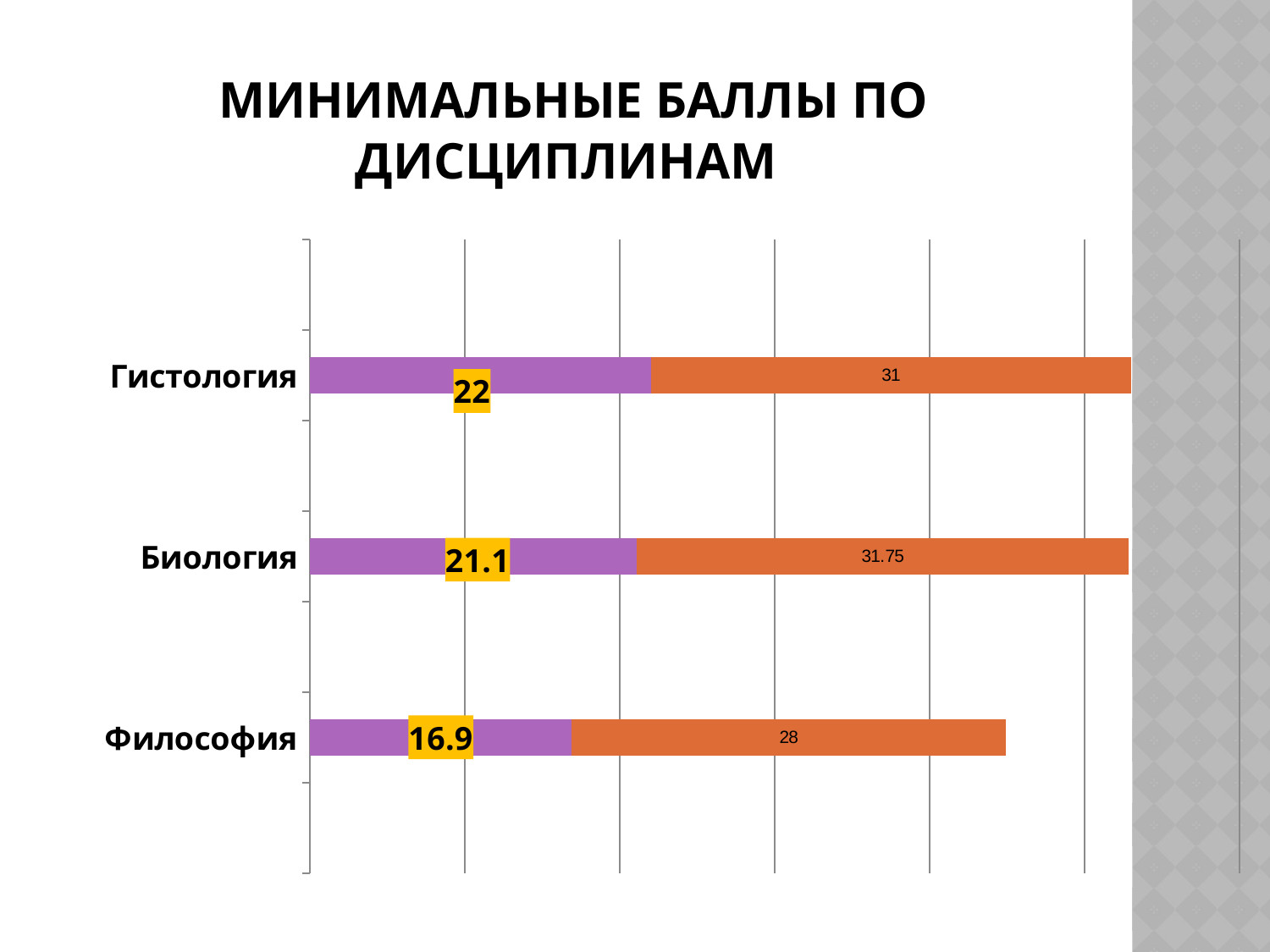
What is the title of the chart on the slide? МИНИМАЛЬНЫЕ БАЛЛЫ ПО ДИСЦИПЛИНАМ Which category has the highest purple segment value? Гистология What is the value of the orange segment for Биология? 31.75 What is the value of the orange segment for Философия? 28 How many categories are shown on the chart? 3 What type of chart is shown on the slide? bar chart Which is larger: the purple segment for Биология or the purple segment for Философия? Биология What is the value of the purple segment for Гистология? 22 Which category has the lowest orange segment value? Философия What is the difference between the orange segment values for Биология and Философия? 3.75 What is the value of the purple segment for Философия? 16.9 What is the total of the stacked bar for Гистология? 53